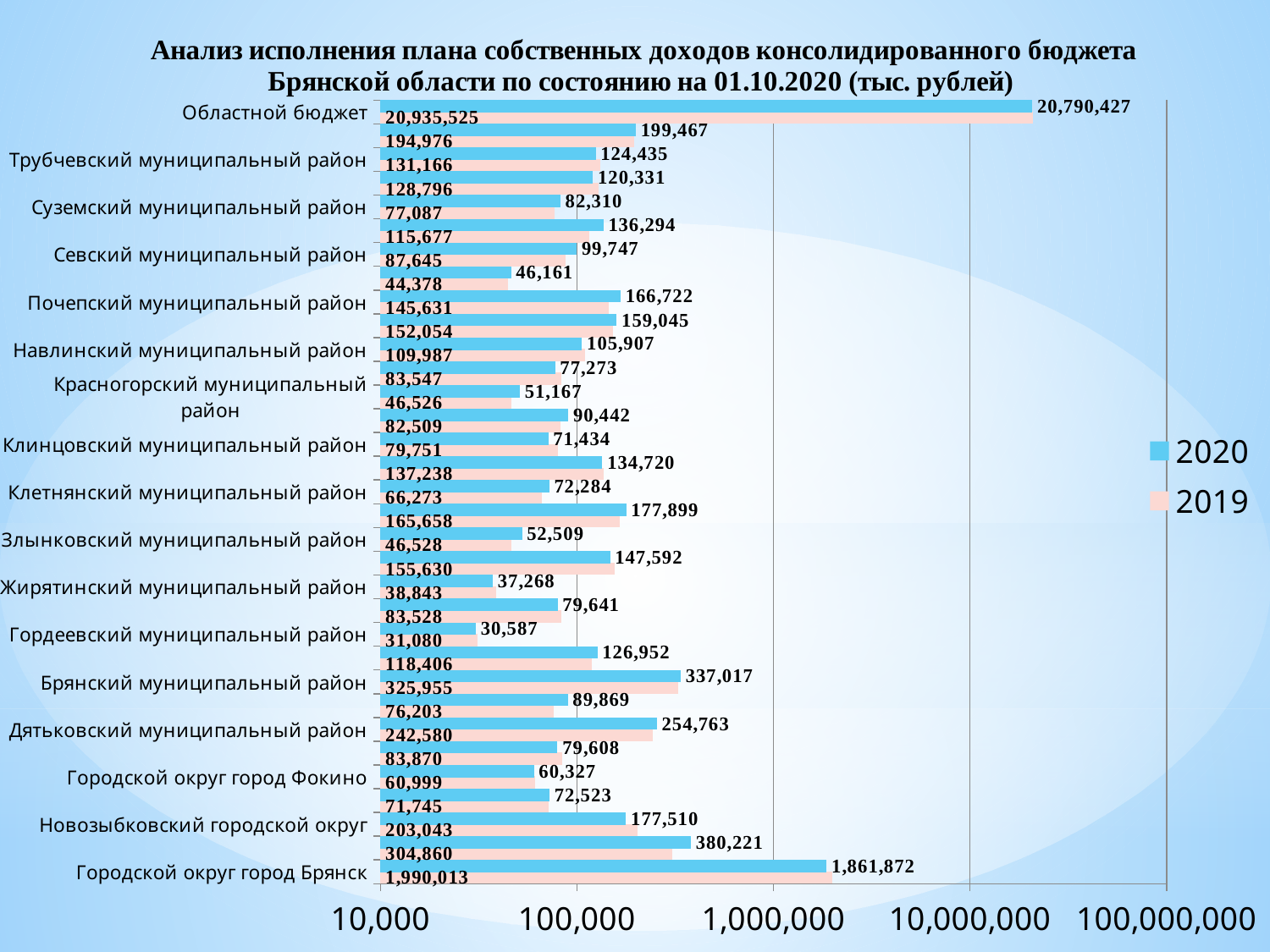
What is the 2020 value for Брянский муниципальный район? 337,017 Which labeled category has the lowest 2020 value? Гордеевский муниципальный район What is the difference between the 2020 and 2019 values for Брянский муниципальный район? 11,062 Which category has the highest 2020 value? Областной бюджет What is the 2019 value for Новозыбковский городской округ? 203,043 Is the 2020 value for Городской округ город Брянск greater or less than 1,000,000? greater What is the 2020 value for Областной бюджет? 20,790,427 What is the 2019 value for Городской округ город Брянск? 1,990,013 What kind of chart is shown on the slide? Bar chart How many series does the legend list? 2 What is the difference between the 2019 and 2020 values for Новозыбковский городской округ? 25,533 For Севский муниципальный район, which year has the larger value, 2020 or 2019? 2020